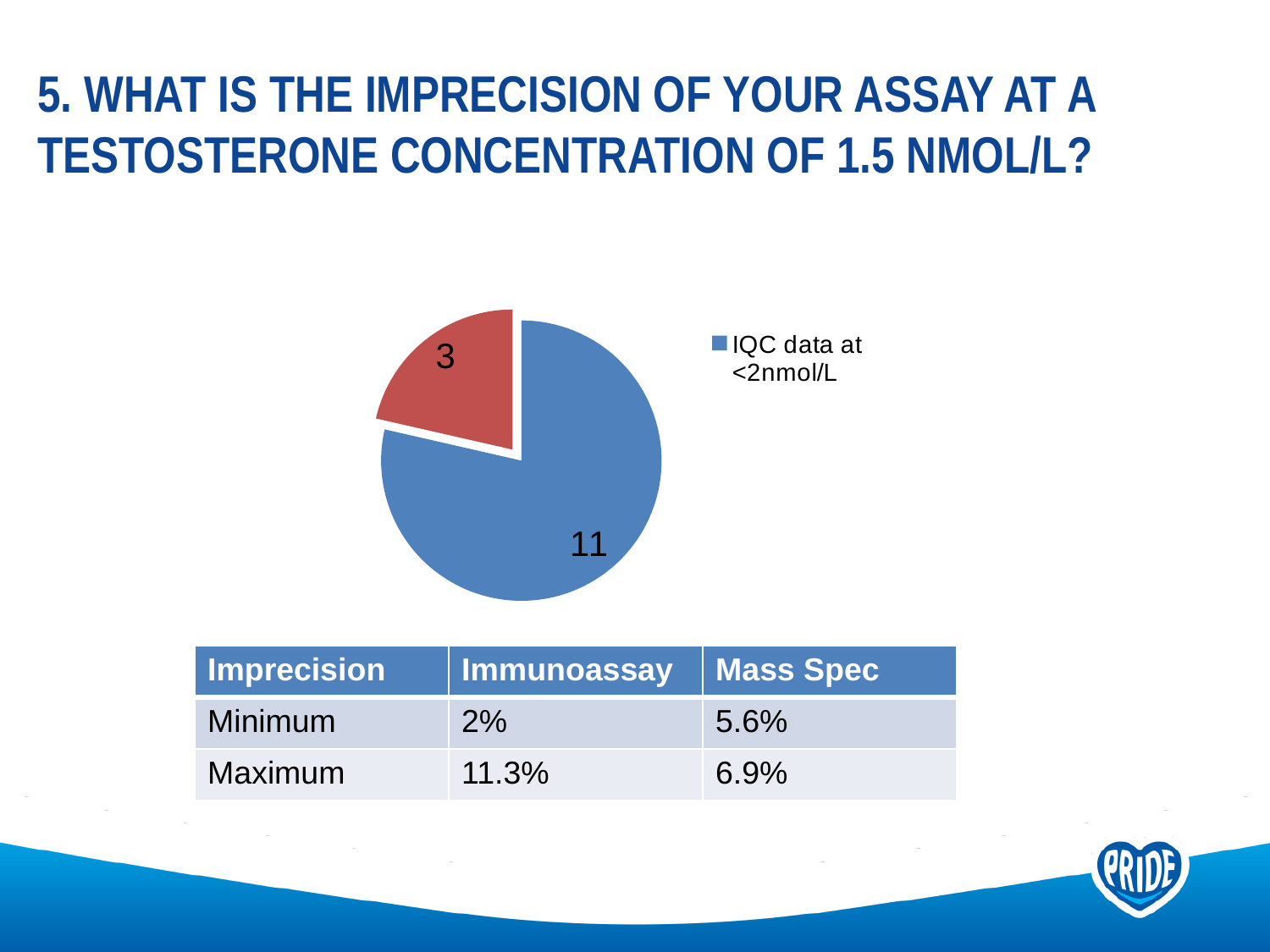
What is the text of the legend entry shown next to the pie chart? IQC data at <2nmol/L What share of the pie does the slice with value 3 represent? 21.4% What value is shown for the slice labelled "IQC data at <2nmol/L" in the pie chart? 11 What is the difference between the two slice values in the pie chart? 8 How many slices does the pie chart have? 2 Which slice is larger in the pie chart, the blue one or the red one? the blue one Which slice of the pie chart is the largest? IQC data at <2nmol/L (11) How many entries does the legend of the pie chart list? 1 What kind of chart is shown on the slide? pie chart What is the total of the two slice values in the pie chart? 14 What is the value of the smallest slice in the pie chart? 3 What value is shown on the red slice of the pie chart? 3